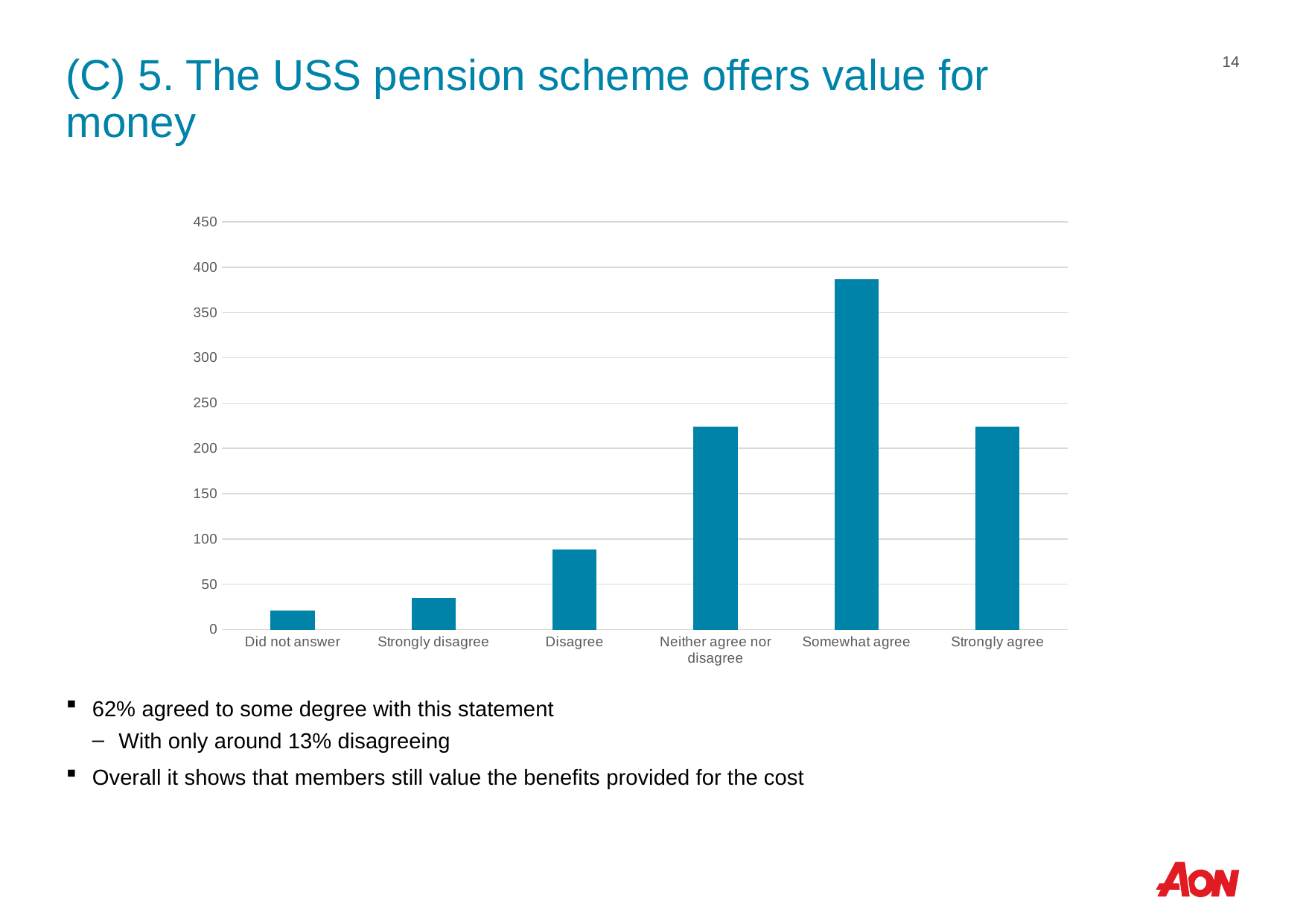
What kind of chart is shown on the slide? bar chart Is the value for Disagree greater or less than 100? less Is the value for Strongly agree greater or less than 200? greater How many categories are shown on the x axis of the chart? 6 Is the value for Neither agree nor disagree greater or less than 250? less What statement does the slide title say the chart is about? The USS pension scheme offers value for money Which category has the lowest bar? Did not answer Which is larger, the value for Somewhat agree or the value for Disagree? Somewhat agree Which category has the highest bar? Somewhat agree